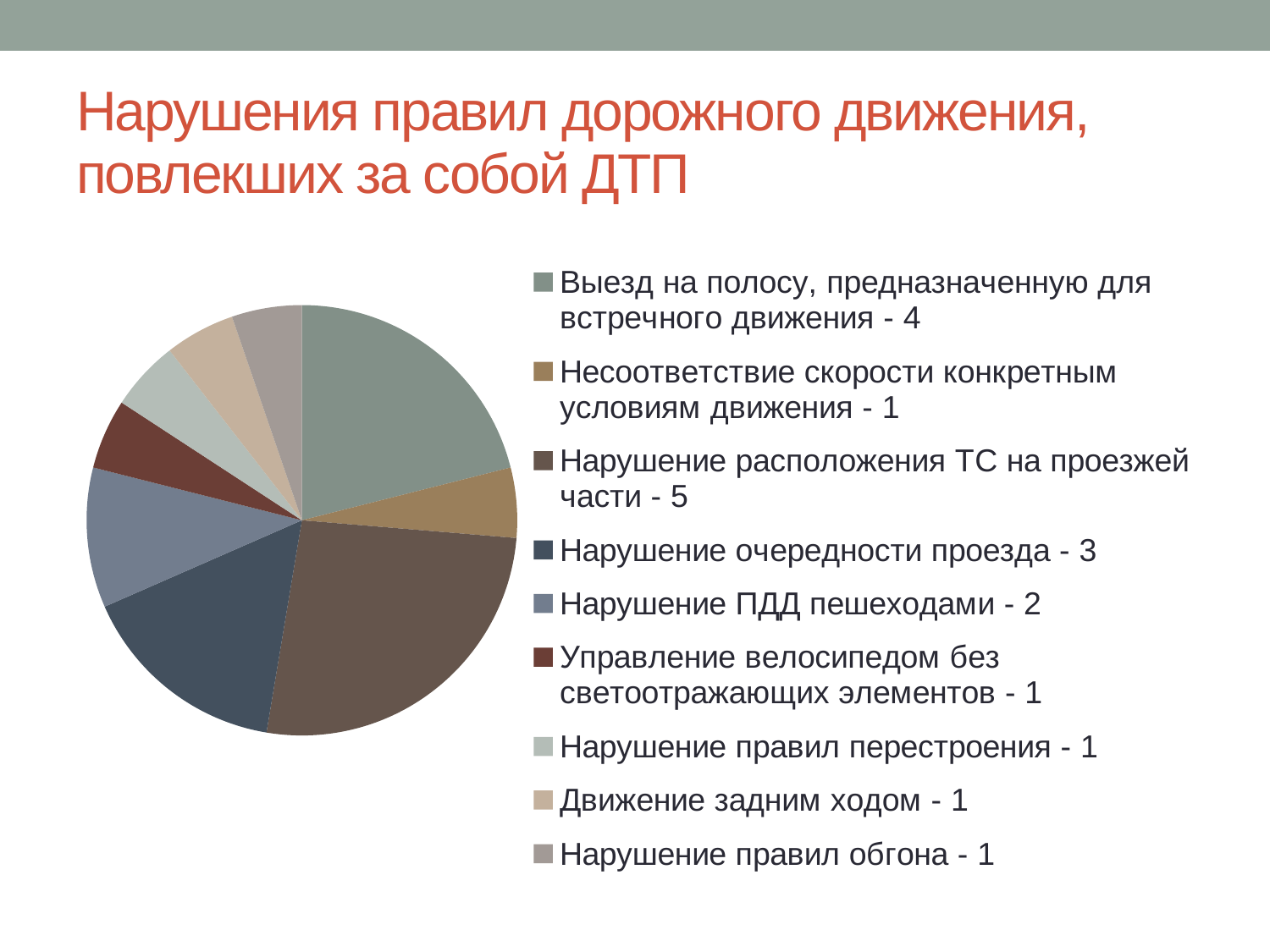
What is the value for "Выезд на полосу, предназначенную для встречного движения"? 4 What is the title of the slide containing the pie chart? Нарушения правил дорожного движения, повлекших за собой ДТП What is the difference between the values for "Нарушение расположения ТС на проезжей части" and "Нарушение ПДД пешеходами"? 3 Which is larger: the value for "Выезд на полосу, предназначенную для встречного движения" or for "Нарушение очередности проезда"? Выезд на полосу, предназначенную для встречного движения What is the total of all the values listed in the legend? 19 What is the value for "Движение задним ходом"? 1 How many categories (slices) does the pie chart have? 9 What is the value for "Нарушение ПДД пешеходами"? 2 What is the value for "Нарушение очередности проезда"? 3 What is the value for "Нарушение расположения ТС на проезжей части"? 5 What kind of chart is shown on the slide? pie chart Which category has the largest value in the pie chart? Нарушение расположения ТС на проезжей части